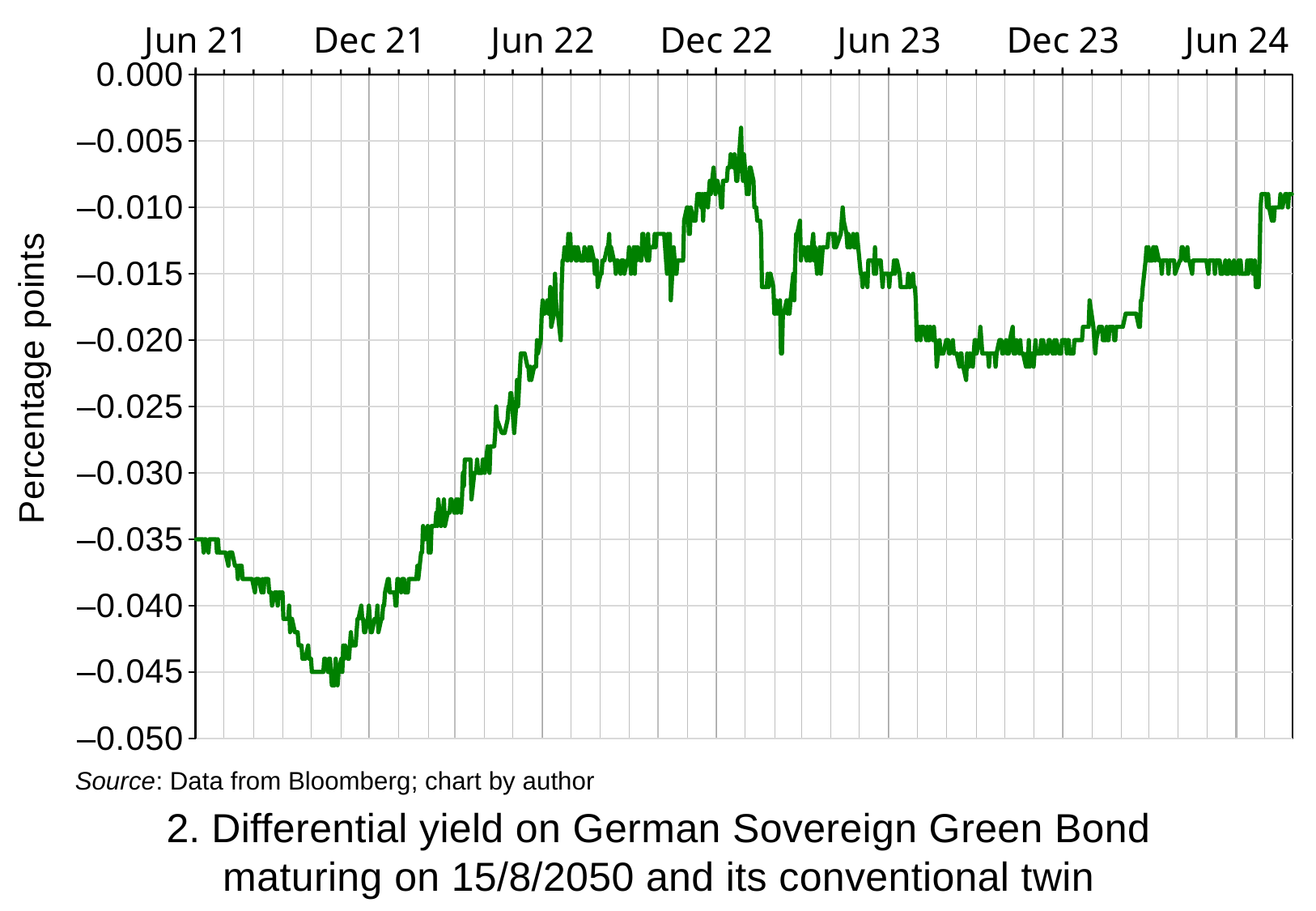
What is the label on the vertical axis of the chart? Percentage points Is the value around Dec 22 greater or less than -0.010? greater Is the value around Jun 22 greater or less than -0.030? greater Is the value at the end of the series (Jun 24) higher or lower than the value at the start (Jun 21)? Higher Around which x-axis label does the line reach its highest point? Dec 22 What kind of chart is shown on the slide? Line chart Around which x-axis label does the line reach its lowest point? Dec 21 Does the differential yield rise or fall between Jun 21 and Dec 21? Fall What is the title of the chart? 2. Differential yield on German Sovereign Green Bond maturing on 15/8/2050 and its conventional twin Does the differential yield rise or fall between Dec 21 and Dec 22? Rise How many date labels are shown along the x axis? 7